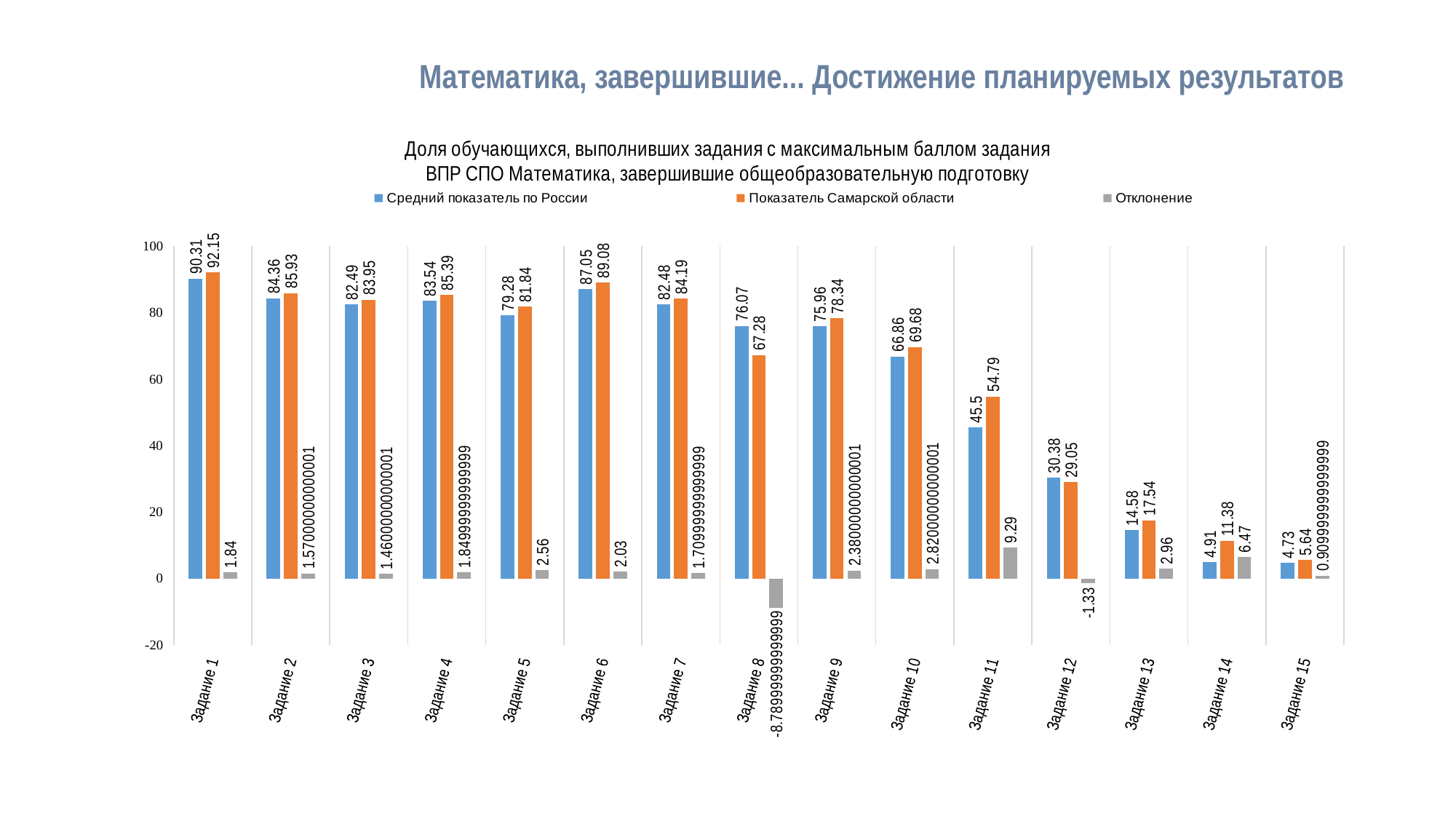
What kind of chart is shown on the slide? Bar chart Which category has the lowest value for «Средний показатель по России»? Задание 15 Is the value of «Показатель Самарской области» for Задание 10 greater or less than 60? greater For Задание 12, which is larger: «Средний показатель по России» or «Показатель Самарской области»? Средний показатель по России How many categories (задания) are shown on the x axis? 15 What is the «Отклонение» value for Задание 14? 6.47 What is the value of «Показатель Самарской области» for Задание 11? 54.79 What is the difference between «Средний показатель по России» and «Показатель Самарской области» for Задание 8? 8.79 How many series does the legend list? 3 Do the values of «Средний показатель по России» generally rise or fall from Задание 1 to Задание 15? Fall What is the value of «Средний показатель по России» for Задание 1? 90.31 Which category has the highest value for «Показатель Самарской области»? Задание 1